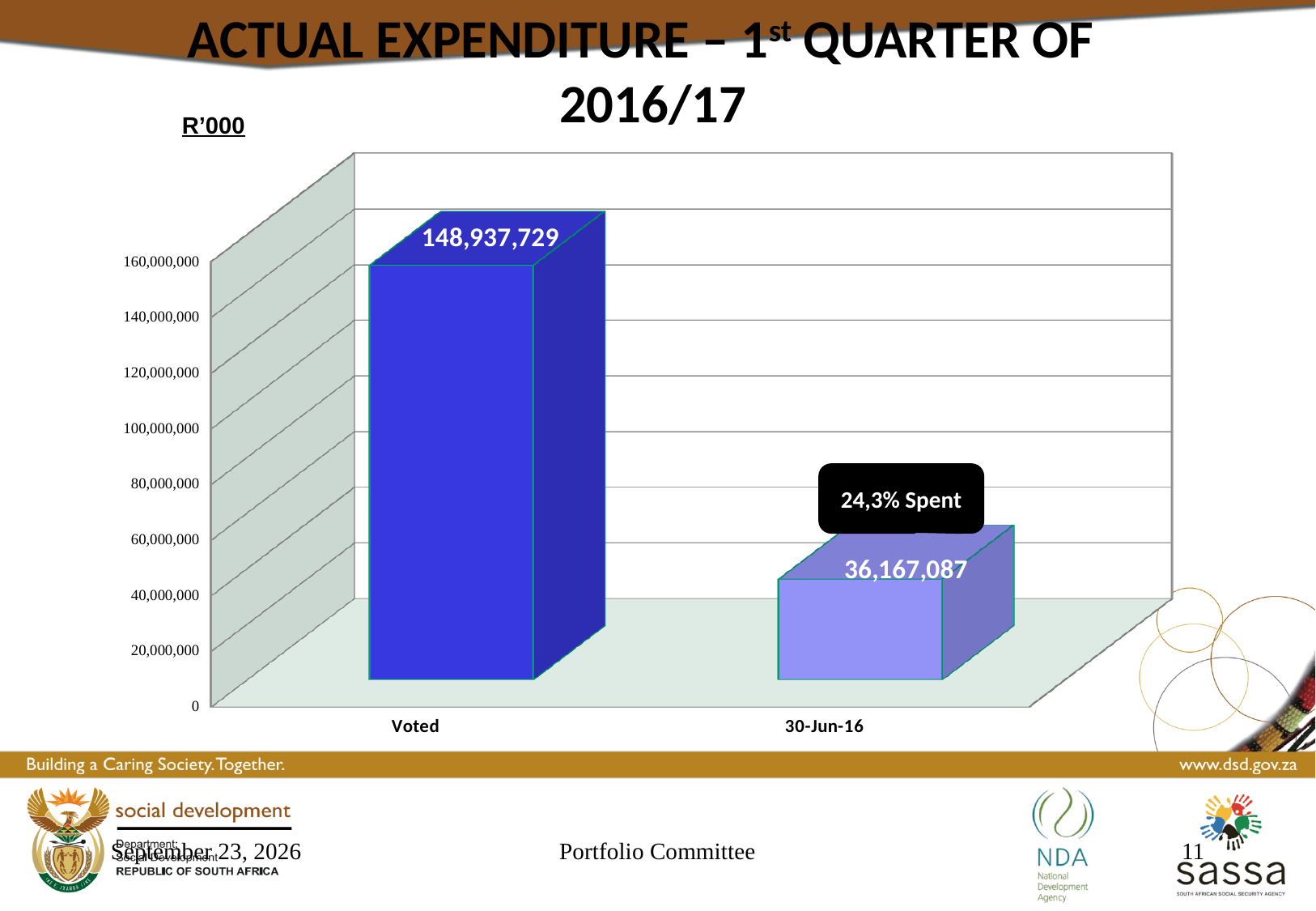
What is the difference between the Voted value and the 30-Jun-16 value? 112,770,642 How many categories are shown on the x axis? 2 Which category has the lowest value? 30-Jun-16 What percentage spent is shown in the label above the 30-Jun-16 bar? 24,3% Spent Is the value for Voted greater or less than 140,000,000? greater Which category has the highest value? Voted What unit is indicated at the top left of the chart? R'000 Is the value for 30-Jun-16 greater or less than 40,000,000? less What is the value for 30-Jun-16? 36,167,087 What kind of chart is shown on the slide? bar chart Which is larger, the value for Voted or the value for 30-Jun-16? Voted What is the value for Voted? 148,937,729